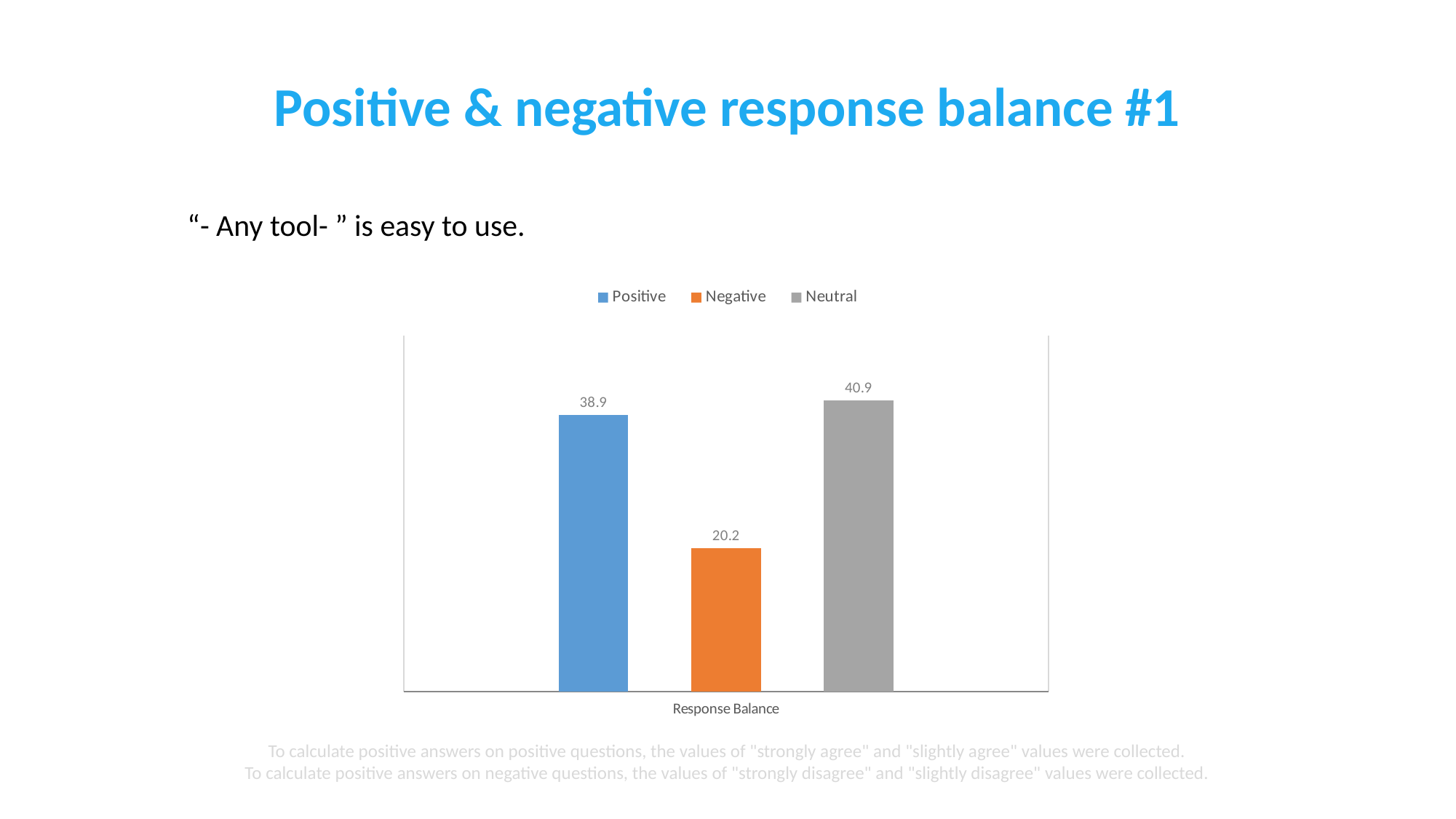
What is the label on the x axis of the chart? Response Balance What is the value for Positive? 38.9 What colour is the Negative bar? Orange Which series has the lowest value? Negative What is the difference between the Positive and Negative values? 18.7 What is the difference between the Neutral and Positive values? 2.0 Which series has the highest value? Neutral How many series does the legend list? 3 Which is larger, the Positive value or the Negative value? Positive What kind of chart is shown on the slide? Bar chart What is the value for Neutral? 40.9 What is the value for Negative? 20.2